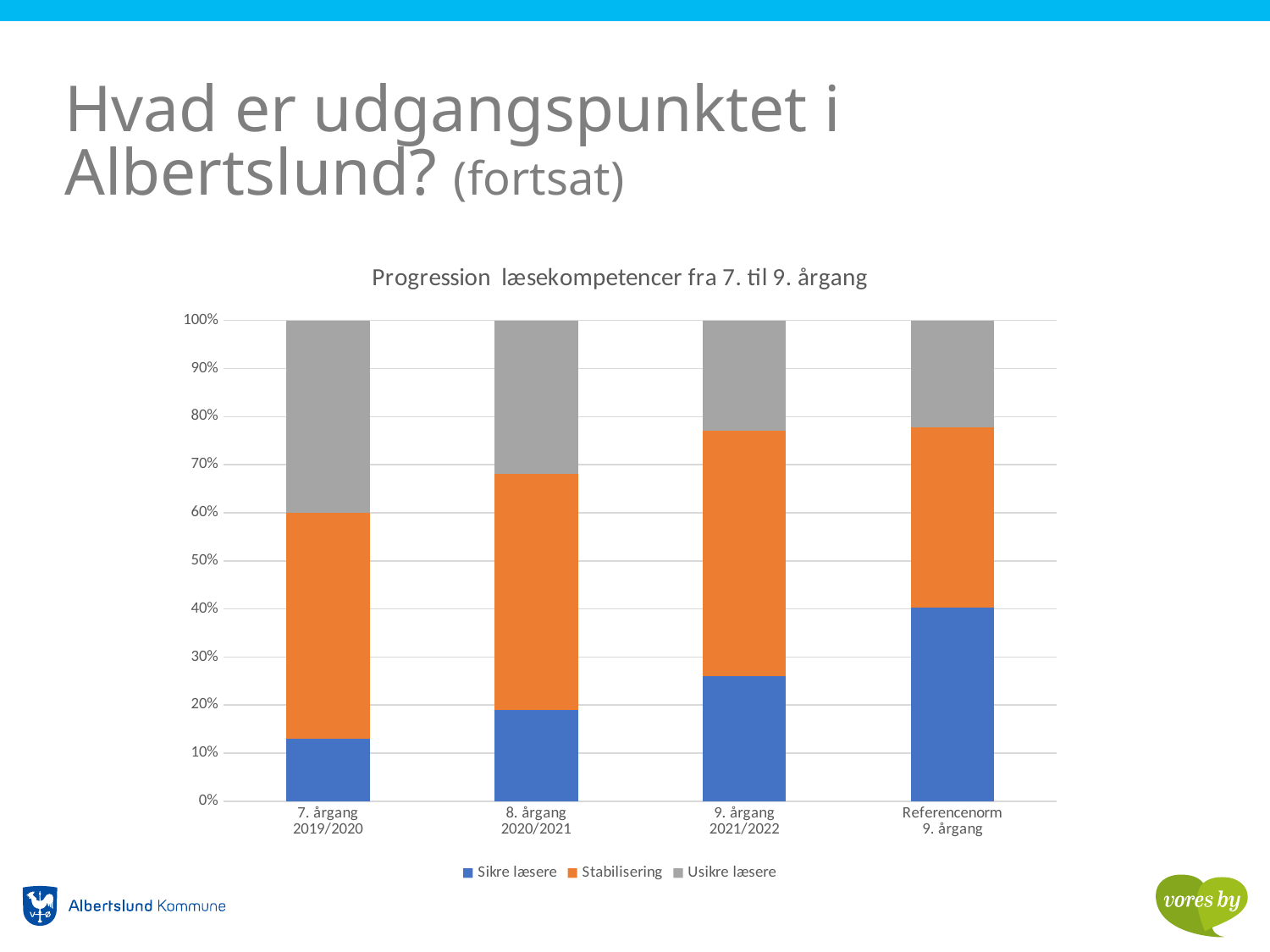
Which colour represents Stabilisering in the chart's legend? Orange Which category has the smallest share of Sikre læsere? 7. årgang 2019/2020 What is the title of the chart? Progression læsekompetencer fra 7. til 9. årgang Is the share of Sikre læsere for 7. årgang 2019/2020 greater or less than 20%? less Which category has the largest share of Usikre læsere? 7. årgang 2019/2020 How many categories are shown along the x axis of the chart? 4 Which category has the largest share of Sikre læsere? Referencenorm 9. årgang Does the share of Sikre læsere rise or fall from 7. årgang 2019/2020 to 9. årgang 2021/2022? Rise Is the share of Sikre læsere for Referencenorm 9. årgang greater or less than 30%? greater What kind of chart is shown on the slide? Stacked bar chart How many series does the chart's legend list? 3 Which has the larger share of Sikre læsere: 9. årgang 2021/2022 or Referencenorm 9. årgang? Referencenorm 9. årgang